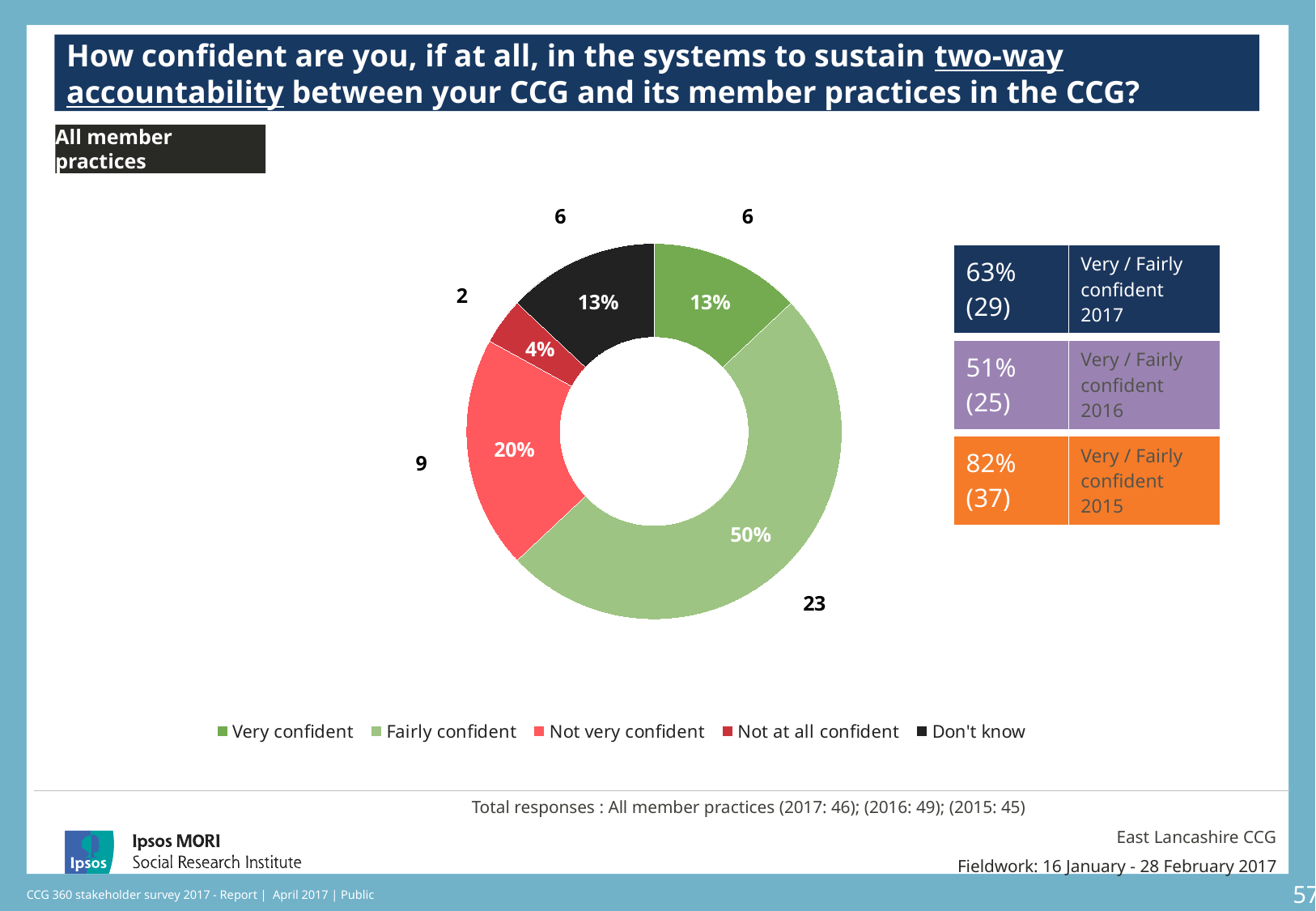
What percentage were Very / Fairly confident in 2017, according to the summary box? 63% How many response categories does the legend list? 5 What is the difference in percentage points between Fairly confident and Not very confident? 30 percentage points What percentage of respondents are Fairly confident? 50% What percentage of respondents are Not very confident? 20% Which response category has the smallest share of the chart? Not at all confident Which is larger: the share for Not very confident or the share for Very confident? Not very confident Which response category has the largest share of the chart? Fairly confident How many respondents answered Don't know? 6 How many respondents answered Fairly confident? 23 What percentage of respondents are Not at all confident? 4% What type of chart is shown on the slide? Donut (pie) chart